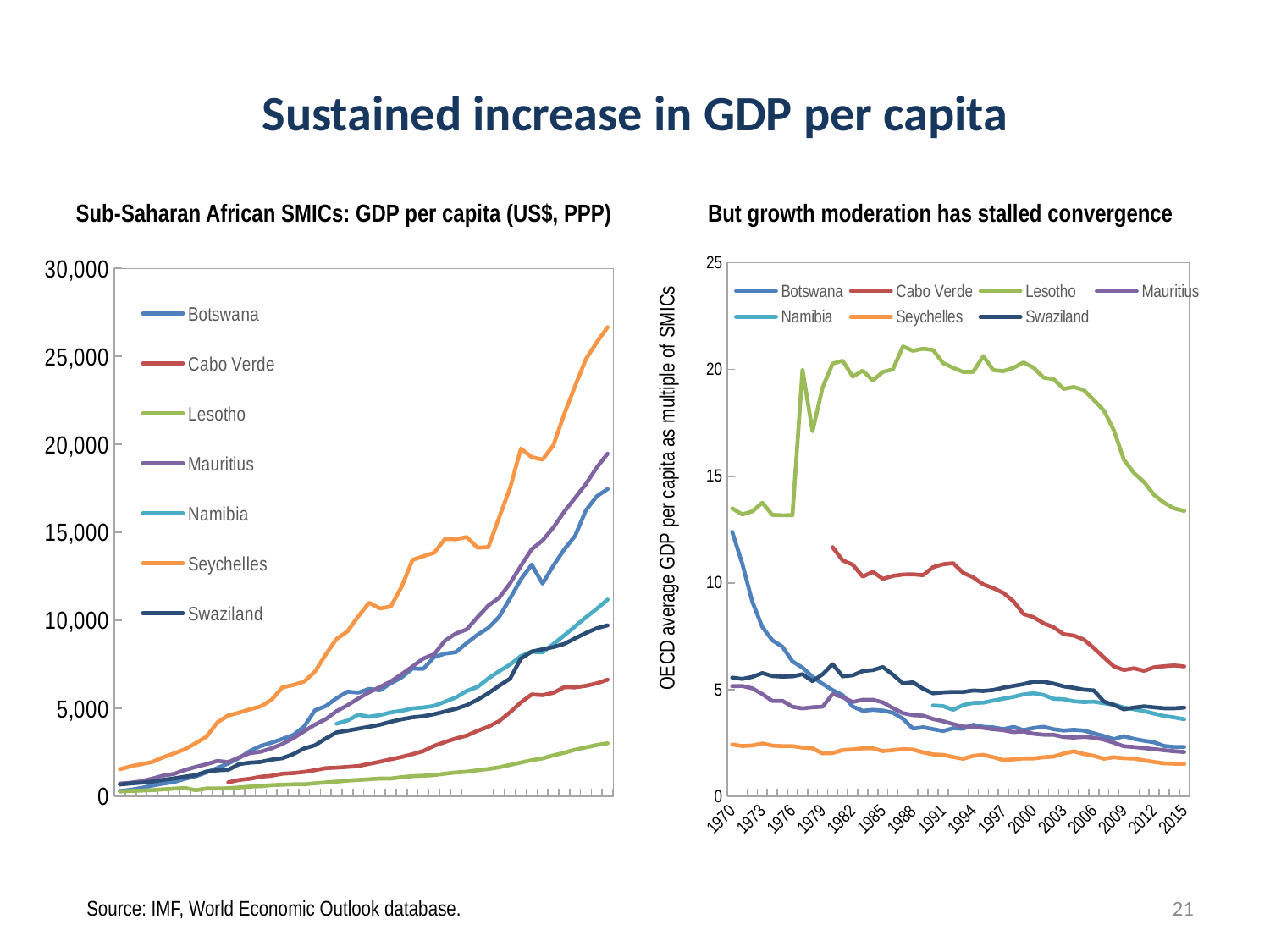
How many series does the legend of the left chart 'Sub-Saharan African SMICs: GDP per capita (US$, PPP)' list? 7 In the left chart 'Sub-Saharan African SMICs: GDP per capita (US$, PPP)', which country has the lowest GDP per capita at the end of the series? Lesotho What is the y-axis label of the right chart 'But growth moderation has stalled convergence'? OECD average GDP per capita as multiple of SMICs In the left chart 'Sub-Saharan African SMICs: GDP per capita (US$, PPP)', does the Seychelles line rise or fall over time? Rise What kind of chart is the left chart titled 'Sub-Saharan African SMICs: GDP per capita (US$, PPP)'? Line chart In the left chart 'Sub-Saharan African SMICs: GDP per capita (US$, PPP)', which country has the highest GDP per capita at the end of the series? Seychelles In the right chart 'But growth moderation has stalled convergence', is the value for Botswana in 1970 greater or less than 10? greater In the left chart 'Sub-Saharan African SMICs: GDP per capita (US$, PPP)', is the final value for Lesotho greater or less than 5,000? less In the left chart 'Sub-Saharan African SMICs: GDP per capita (US$, PPP)', is the final value for Seychelles greater or less than 25,000? greater In the right chart 'But growth moderation has stalled convergence', does the Botswana line rise or fall from 1970 to 2015? Fall How many series does the legend of the right chart 'But growth moderation has stalled convergence' list? 7 In the right chart 'But growth moderation has stalled convergence', which country has the highest value in 2015? Lesotho